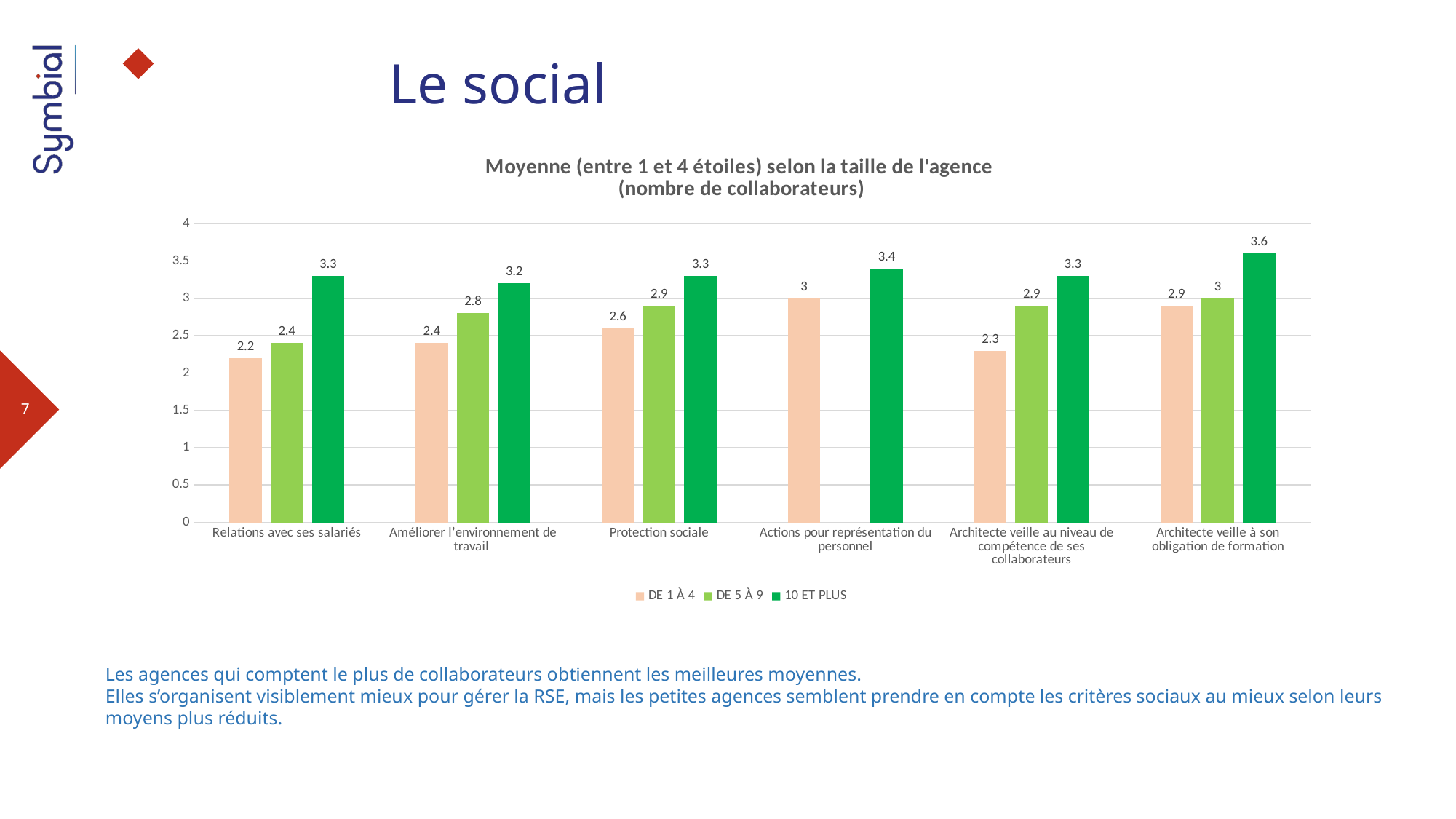
What is the difference between the 10 ET PLUS and DE 1 À 4 values in the category 'Relations avec ses salariés'? 1.1 Which category has the highest value for the 10 ET PLUS series? Architecte veille à son obligation de formation How many categories are shown on the x axis? 6 What is the value for DE 5 À 9 in the category 'Protection sociale'? 2.9 What is the value for 10 ET PLUS in the category 'Architecte veille à son obligation de formation'? 3.6 In the category 'Améliorer l'environnement de travail', which is larger: the DE 5 À 9 value or the 10 ET PLUS value? 10 ET PLUS Which category has the lowest value for the DE 1 À 4 series? Relations avec ses salariés What is the value for DE 1 À 4 in the category 'Actions pour représentation du personnel'? 3 What kind of chart is shown on the slide? Bar chart What is the value for DE 1 À 4 in the category 'Relations avec ses salariés'? 2.2 How many series does the legend list? 3 What is the title of the chart? Moyenne (entre 1 et 4 étoiles) selon la taille de l'agence (nombre de collaborateurs)